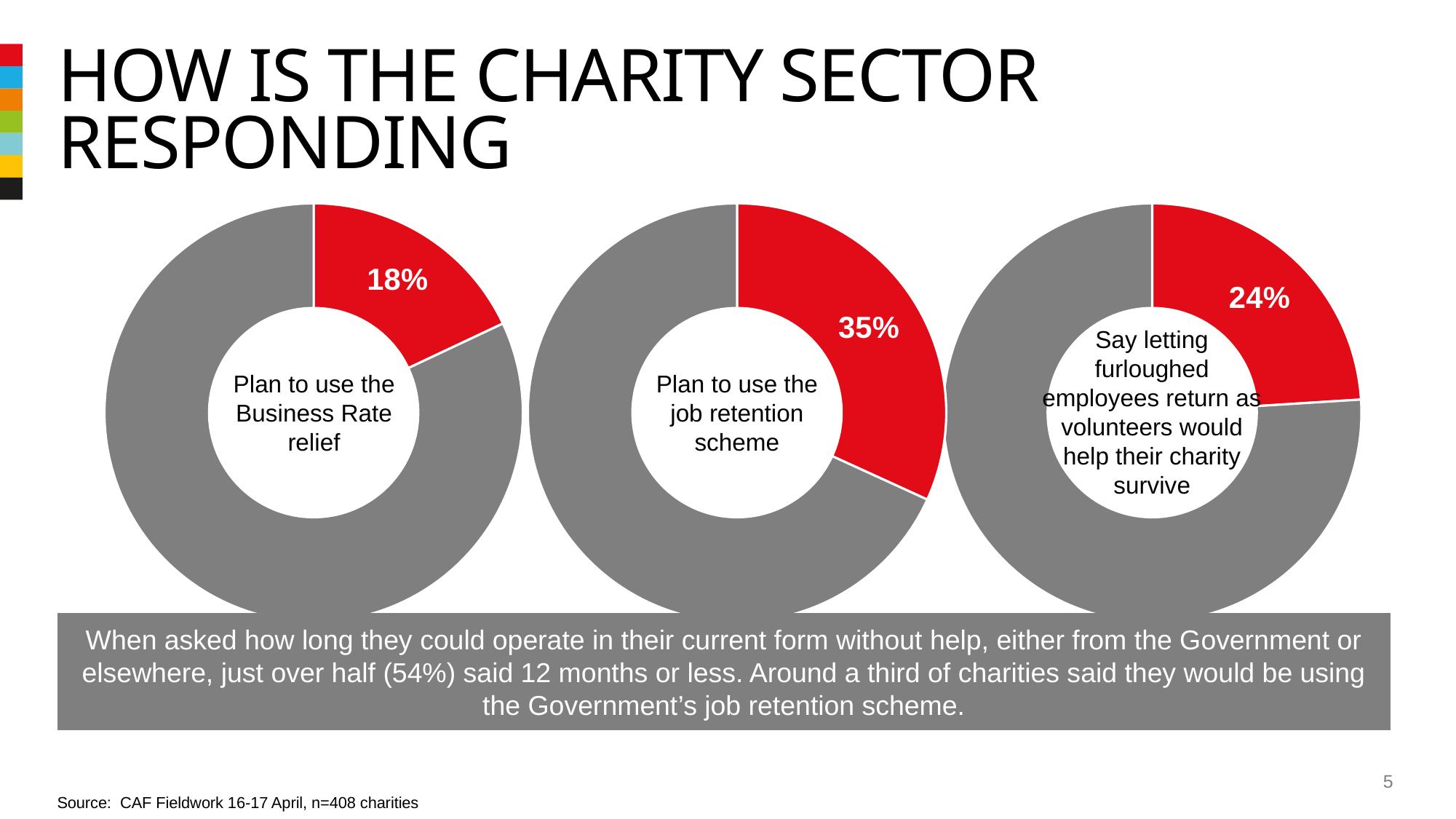
In the right doughnut chart, what percentage say letting furloughed employees return as volunteers would help their charity survive? 24% In the left doughnut chart, what percentage of charities plan to use the Business Rate relief? 18% How many doughnut charts are shown on the slide? 3 Which of the three doughnut charts shows the highest highlighted percentage? Plan to use the job retention scheme What is the difference between the percentage saying furloughed employees returning as volunteers would help and the percentage planning to use the Business Rate relief? 6% In the middle doughnut chart, what percentage of charities plan to use the job retention scheme? 35% What is the difference between the percentage planning to use the job retention scheme and the percentage planning to use the Business Rate relief? 17% What colour is used for the highlighted segment in each doughnut chart? Red Which of the three doughnut charts shows the lowest highlighted percentage? Plan to use the Business Rate relief Which is larger: the percentage planning to use the job retention scheme or the percentage saying furloughed employees returning as volunteers would help? Plan to use the job retention scheme What kind of chart is used to show the three percentages on the slide? Doughnut chart